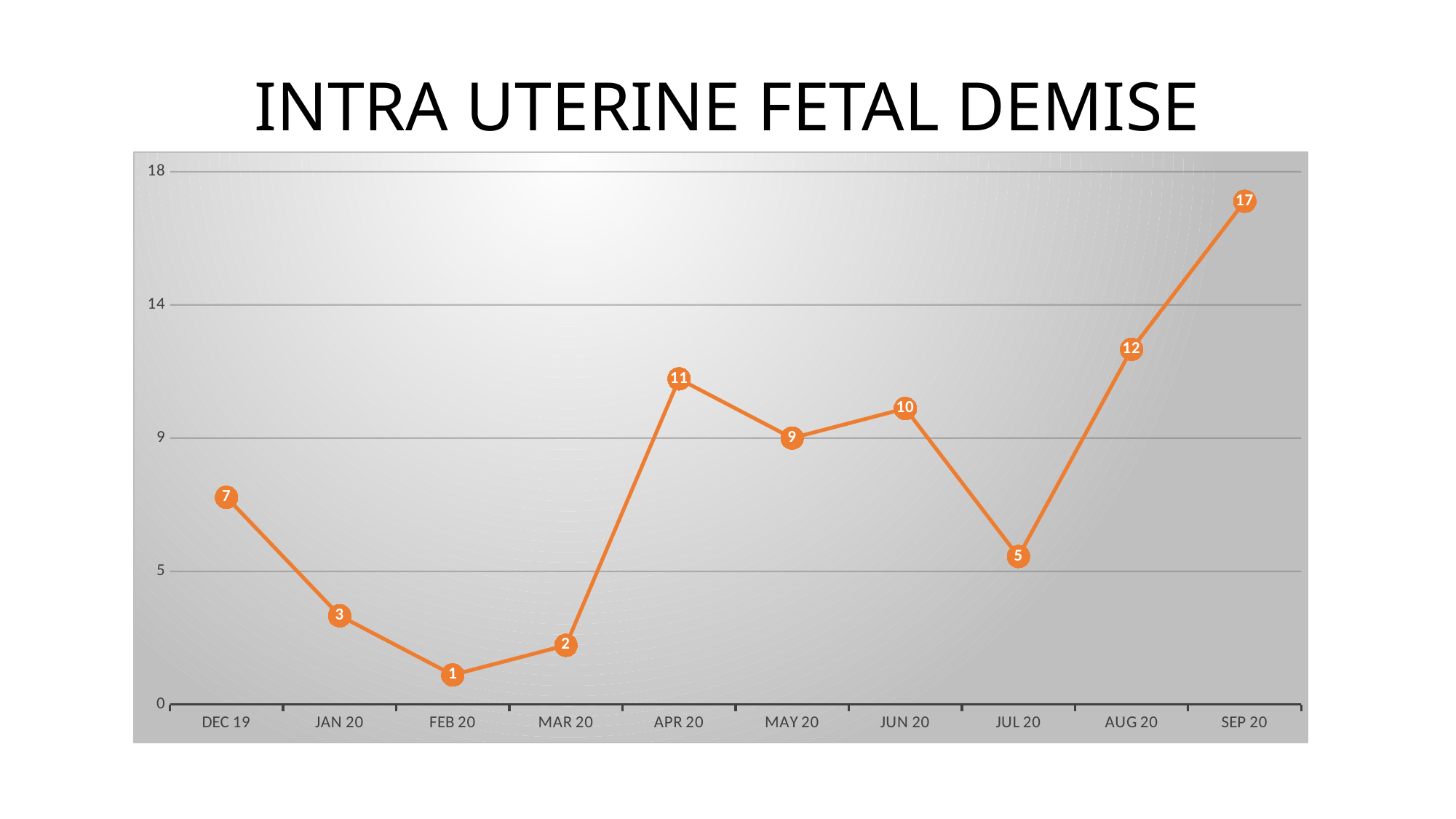
Which month has the highest value? SEP 20 What is the value for SEP 20? 17 What is the difference between the values for SEP 20 and AUG 20? 5 What is the value for APR 20? 11 What kind of chart is shown on the slide? line chart How many months are plotted on the x axis? 10 Do the values rise or fall from JUL 20 to SEP 20? rise What is the title of the chart? INTRA UTERINE FETAL DEMISE What is the value for DEC 19? 7 Which month has the lowest value? FEB 20 Which is larger, the value for APR 20 or the value for JUN 20? APR 20 Is the value for JUL 20 greater or less than 9? less